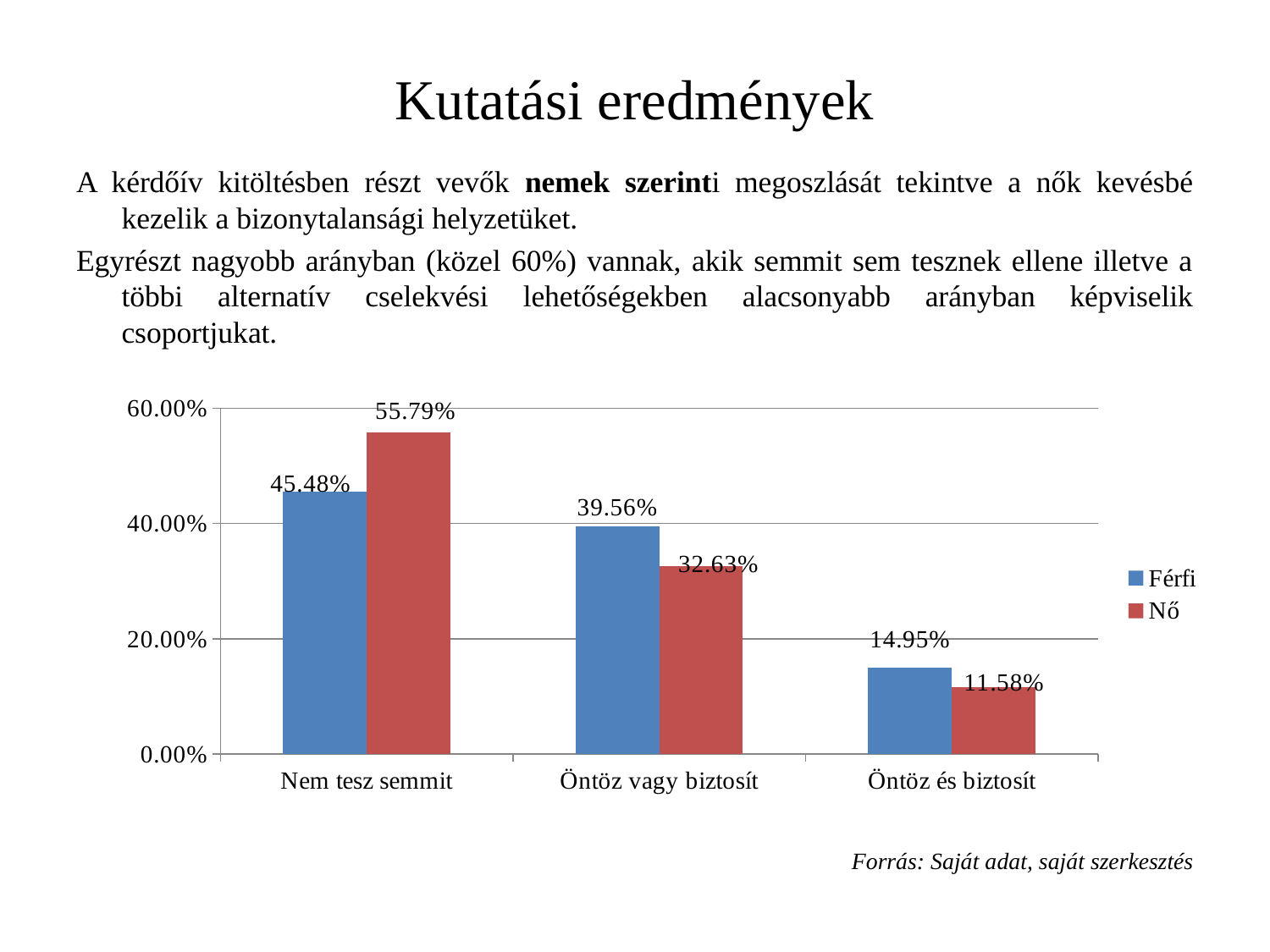
In the Öntöz vagy biztosít category, which series has the larger value, Férfi or Nő? Férfi What is the difference between the Nő and Férfi values in the Nem tesz semmit category? 10.31% Which category has the lowest value for the Férfi series? Öntöz és biztosít What is the value for Férfi in the Öntöz vagy biztosít category? 39.56% Is the value for Nő in the Öntöz vagy biztosít category greater or less than 40.00%? less How many categories are shown on the x axis? 3 What kind of chart is shown on the slide? bar chart What is the value for Nő in the Nem tesz semmit category? 55.79% What is the value for Férfi in the Nem tesz semmit category? 45.48% Which category has the highest value for the Nő series? Nem tesz semmit What is the value for Nő in the Öntöz és biztosít category? 11.58% How many series does the legend list? 2